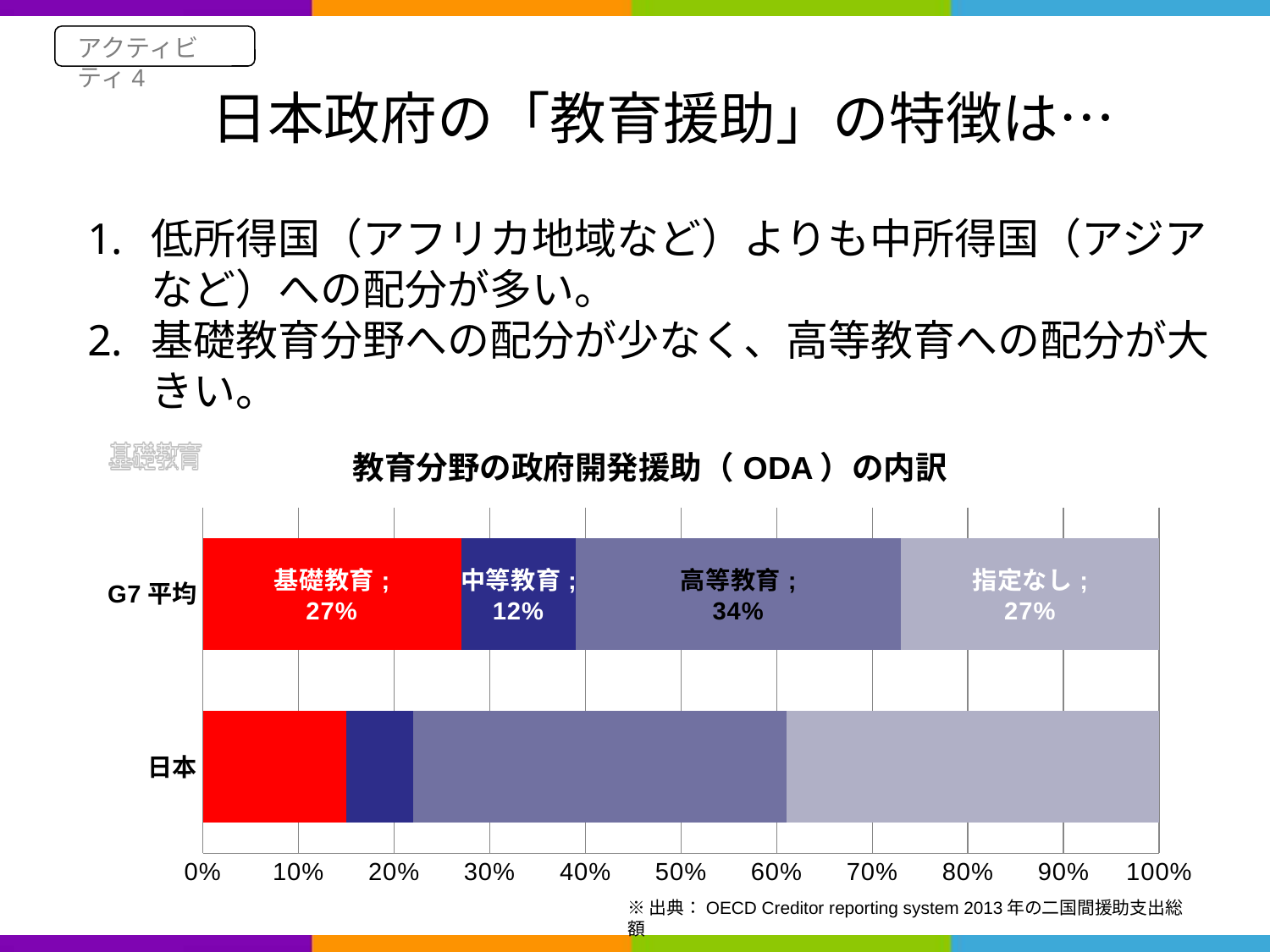
In the chart 教育分野の政府開発援助（ODA）の内訳, what is the value of 基礎教育 for G7平均? 27% What is the title of the chart? 教育分野の政府開発援助（ODA）の内訳 Which segment is the largest in the G7平均 bar? 高等教育 What is the value of 中等教育 for G7平均? 12% What is the value of 指定なし for G7平均? 27% What kind of chart is shown on the slide? Stacked bar chart What is the difference between 高等教育 and 中等教育 for G7平均? 22 percentage points Is the 基礎教育 share for 日本 greater or less than 20%? less Which segment is the smallest in the G7平均 bar? 中等教育 Which has a larger 基礎教育 share, G7平均 or 日本? G7平均 How many categories (bars) are shown in the chart? 2 What is the value of 高等教育 for G7平均? 34%